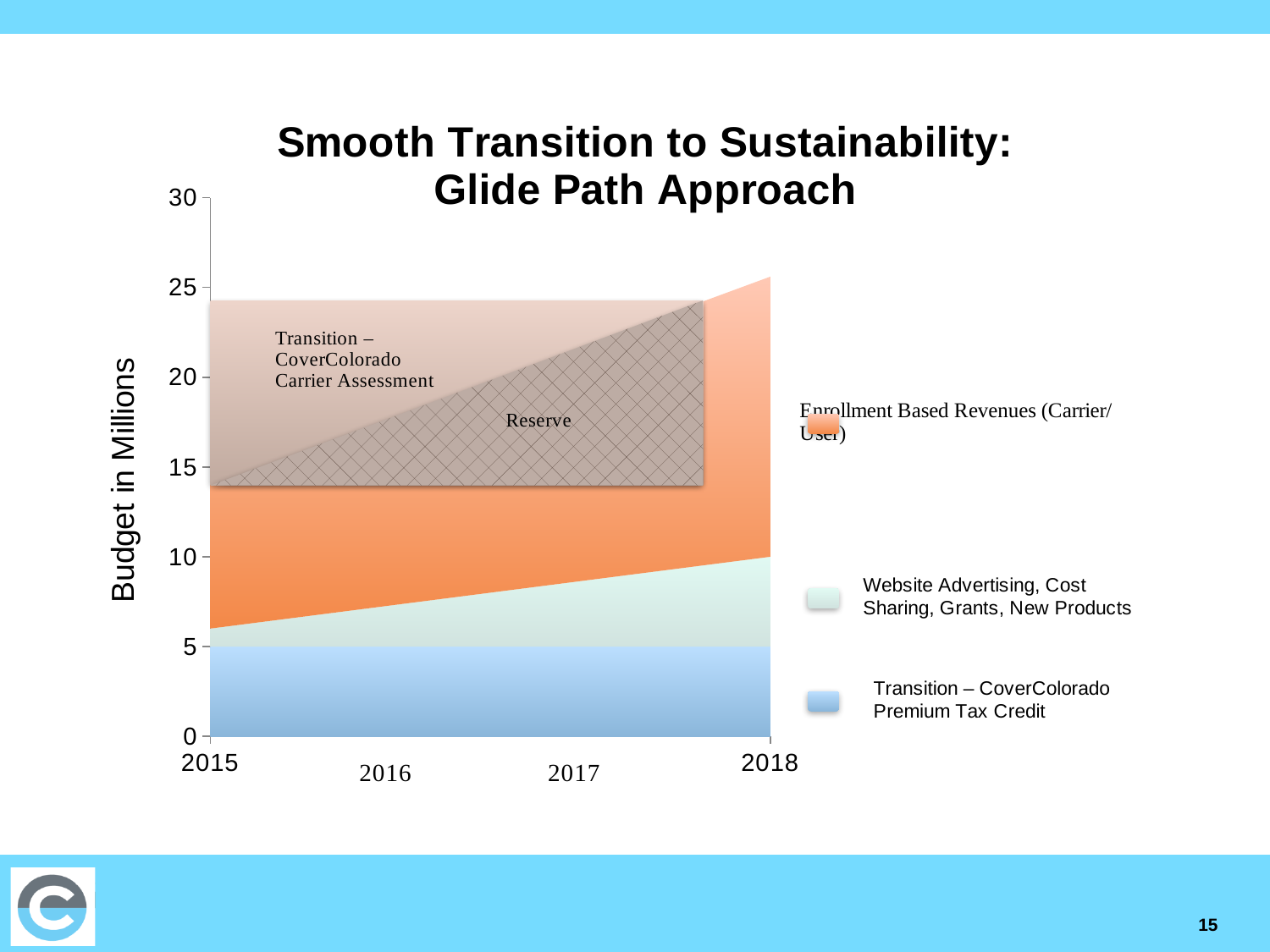
Is the total budget in 2015 greater or less than 20? less Is the total budget in 2018 greater or less than 20? greater What is the title of the chart? Smooth Transition to Sustainability: Glide Path Approach Does the total budget rise or fall from 2015 to 2018? Rises Is the top of the Website Advertising, Cost Sharing, Grants, New Products layer in 2015 greater or less than 10? less Which year has the higher total budget, 2015 or 2018? 2018 What is the label on the vertical axis of the chart? Budget in Millions What is the value of the Transition – CoverColorado Premium Tax Credit series in 2015? 5 What kind of chart is shown on the slide? Area chart How many series does the chart's legend list? 3 How many years are shown along the x axis of the chart? 4